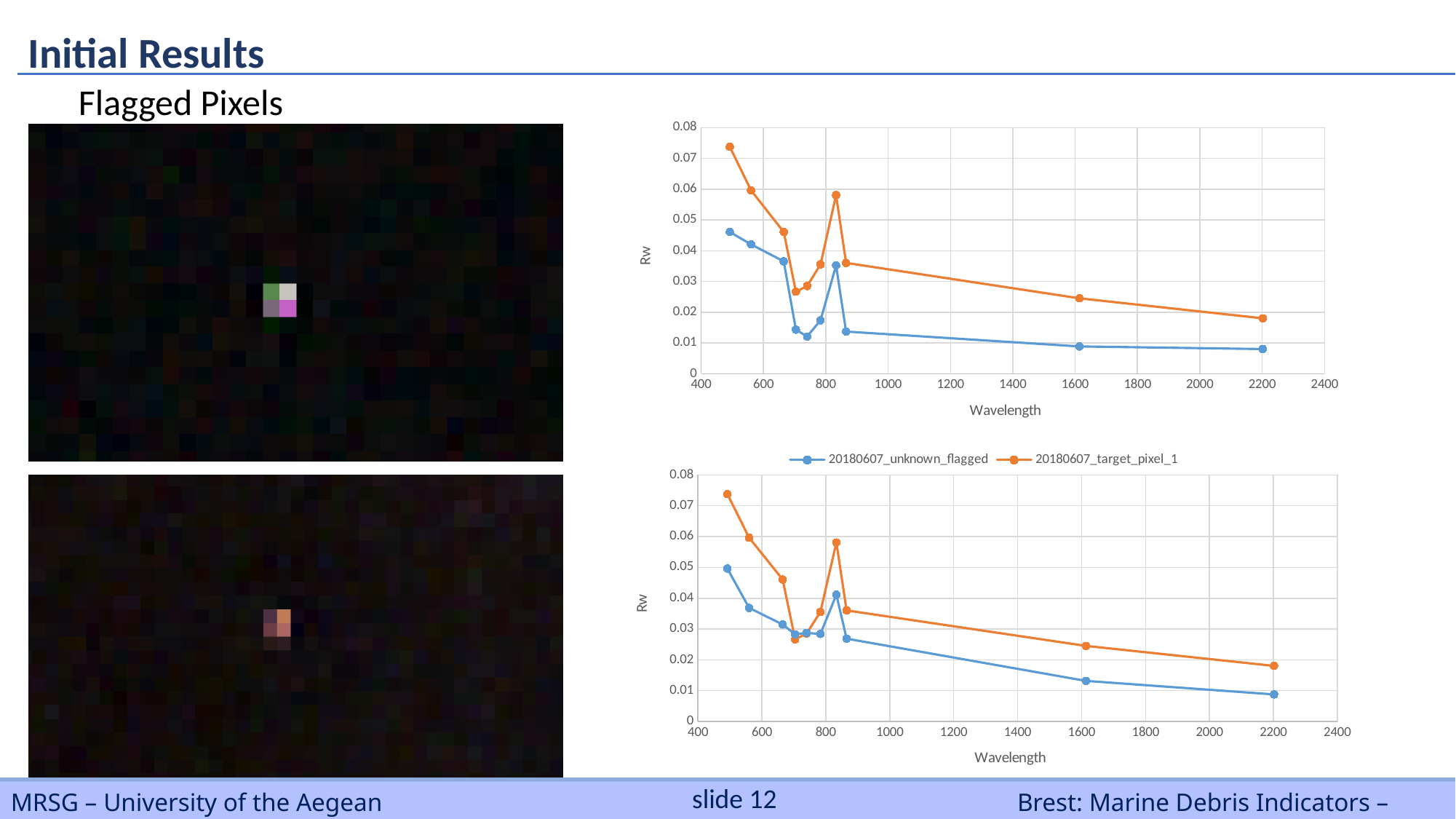
In the top chart, does the blue series end at wavelength 2200 higher or lower than it starts near wavelength 500? lower In the top chart, is the first value of the orange series (near wavelength 500) greater or less than 0.07? greater In the top chart, is the value of the orange series at wavelength 2200 greater or less than 0.02? less What kind of chart is the top chart on the right of the slide? line chart What are the names of the two series in the legend on the slide? 20180607_unknown_flagged and 20180607_target_pixel_1 In the bottom chart, is the value of the blue series at wavelength 1600 greater or less than 0.01? greater In the bottom chart, which series has the higher value at wavelength 2200, the blue series or the orange series? the orange series How many data points does the orange series have in the top chart? 10 What is the label of the x axis on the bottom chart? Wavelength How many series does the legend on the slide list? 2